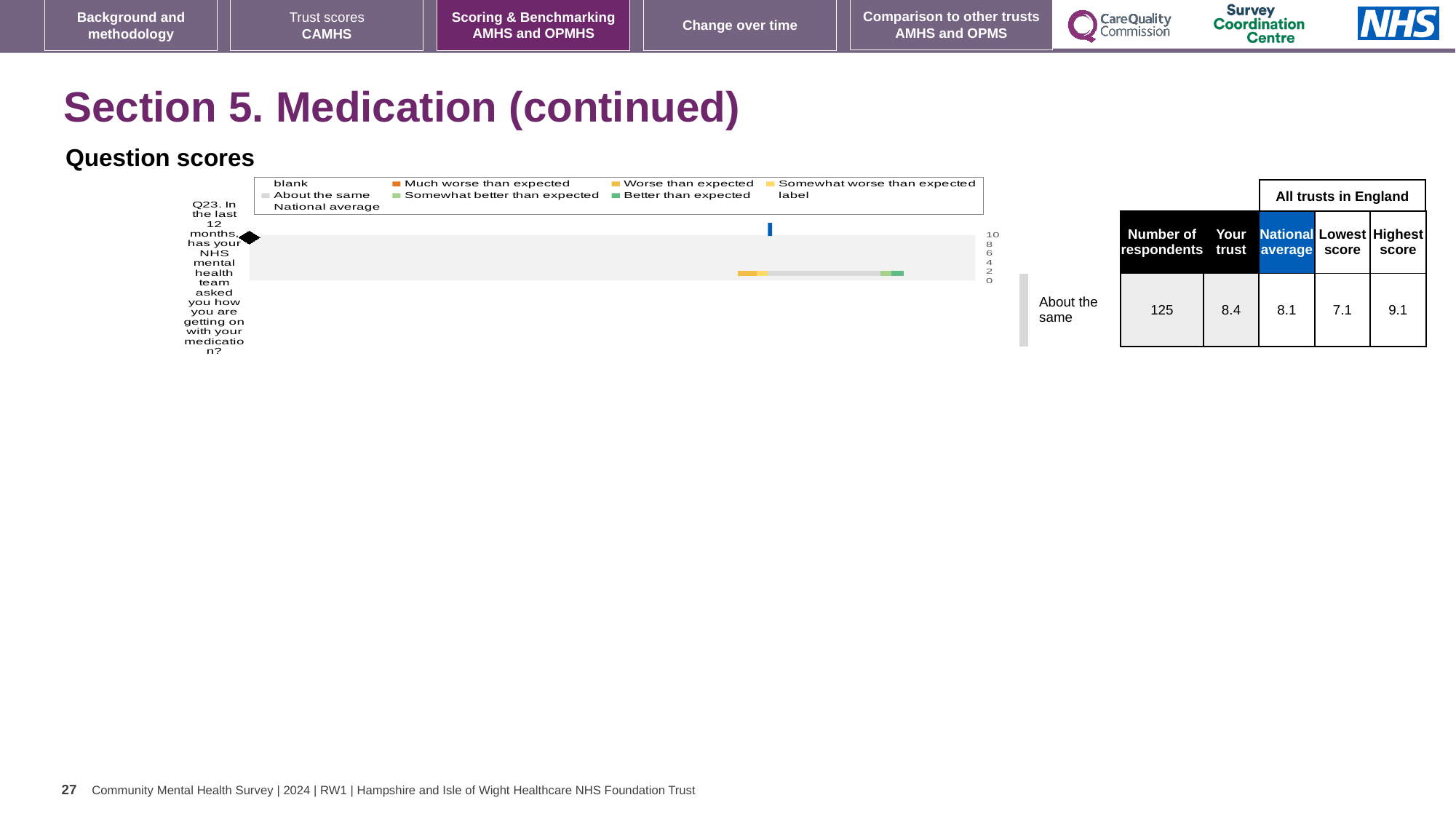
How many questions (categories) are plotted in the Question scores chart? 1 What is the difference between the Highest score and the Lowest score for Q23 in the table beside the chart? 2.0 According to the table beside the chart, what is the Highest score among all trusts in England for Q23? 9.1 According to the table beside the chart, what is the Lowest score among all trusts in England for Q23? 7.1 Which question is plotted in the Question scores chart? Q23. In the last 12 months, has your NHS mental health team asked you how you are getting on with your medication? What kind of chart is shown under 'Question scores'? bar chart According to the table beside the chart, what is the National average score for Q23? 8.1 What is the highest tick value shown on the score axis of the Question scores chart? 10 According to the table beside the chart, what is the 'Your trust' score for Q23? 8.4 Is the 'Your trust' score for Q23 higher or lower than the National average? higher How many respondents answered Q23 according to the table beside the chart? 125 What benchmark category is the trust's Q23 score assigned to on the slide? About the same